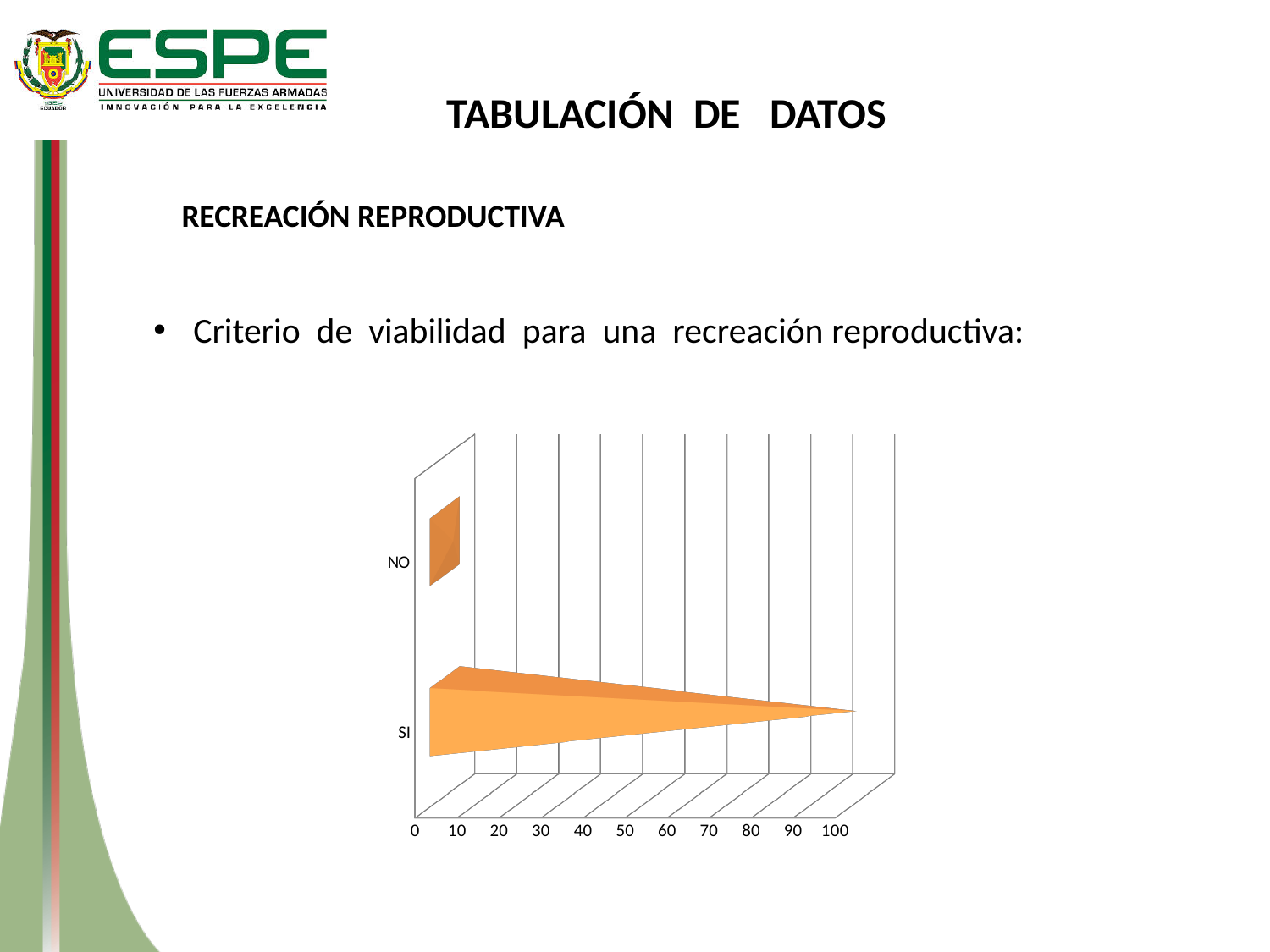
Is the value for SI greater or less than 50? greater What is the highest tick value shown on the horizontal axis of the chart? 100 Is the value for NO greater or less than 10? less What kind of chart is shown on the slide? bar chart What are the two category labels shown on the vertical axis of the chart? NO and SI Which is larger, the value for SI or the value for NO? SI Is the value for SI greater or less than 90? greater Which category has the highest value in the chart? SI Which category has the lowest value in the chart? NO How many categories are plotted in the chart? 2